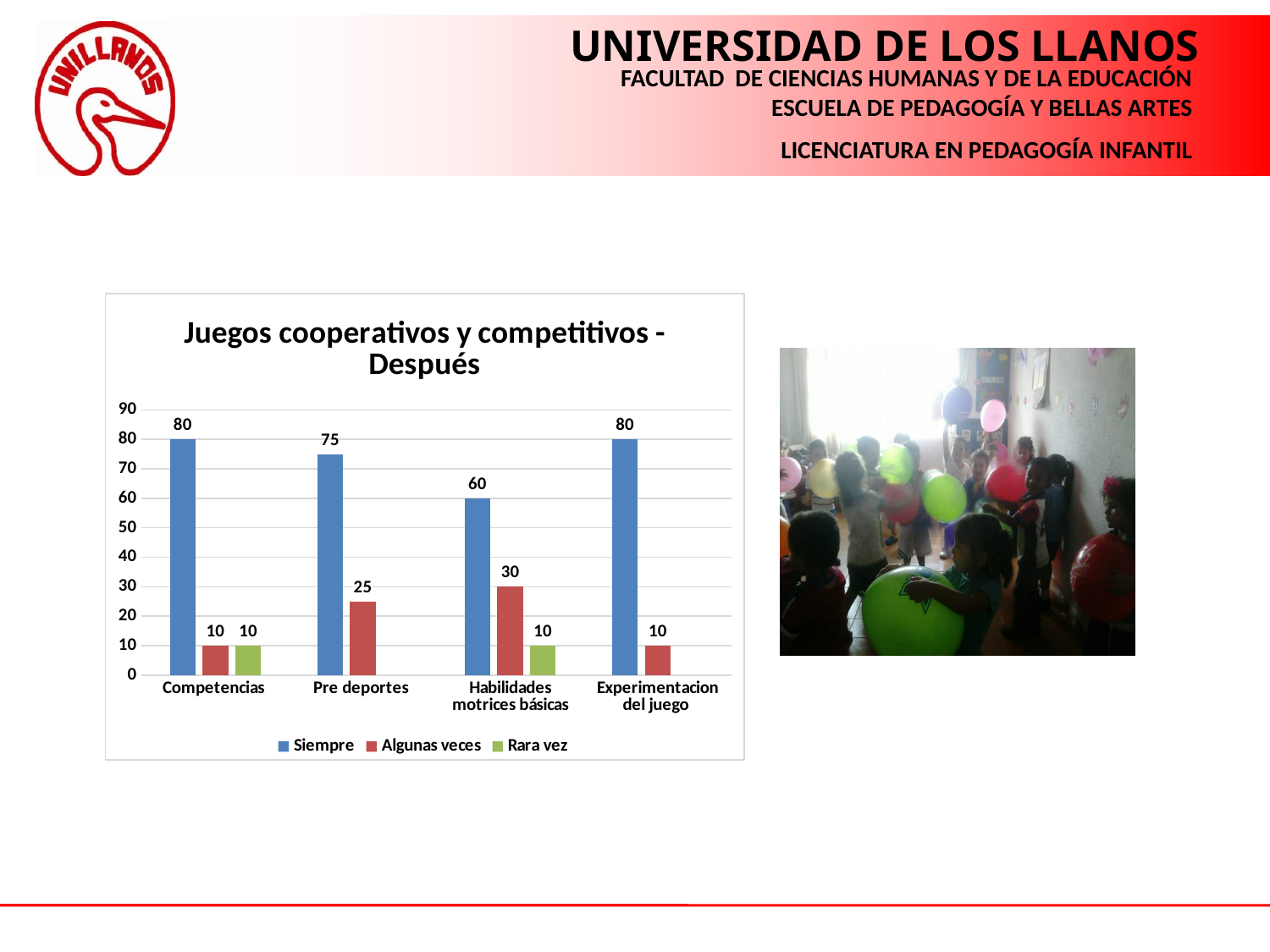
What is the title of the chart? Juegos cooperativos y competitivos - Después Which is larger: the Algunas veces value for Pre deportes or the Algunas veces value for Competencias? Pre deportes What kind of chart is shown? Bar chart What is the value of Algunas veces for Pre deportes? 25 What is the difference between the Siempre value for Pre deportes and the Siempre value for Habilidades motrices básicas? 15 What is the value of Rara vez for Habilidades motrices básicas? 10 What is the value of Algunas veces for Experimentacion del juego? 10 Which category has the highest Algunas veces value? Habilidades motrices básicas How many series does the legend list? 3 Which category has the lowest Siempre value? Habilidades motrices básicas What is the value of Siempre for Competencias? 80 How many categories are shown on the x axis? 4